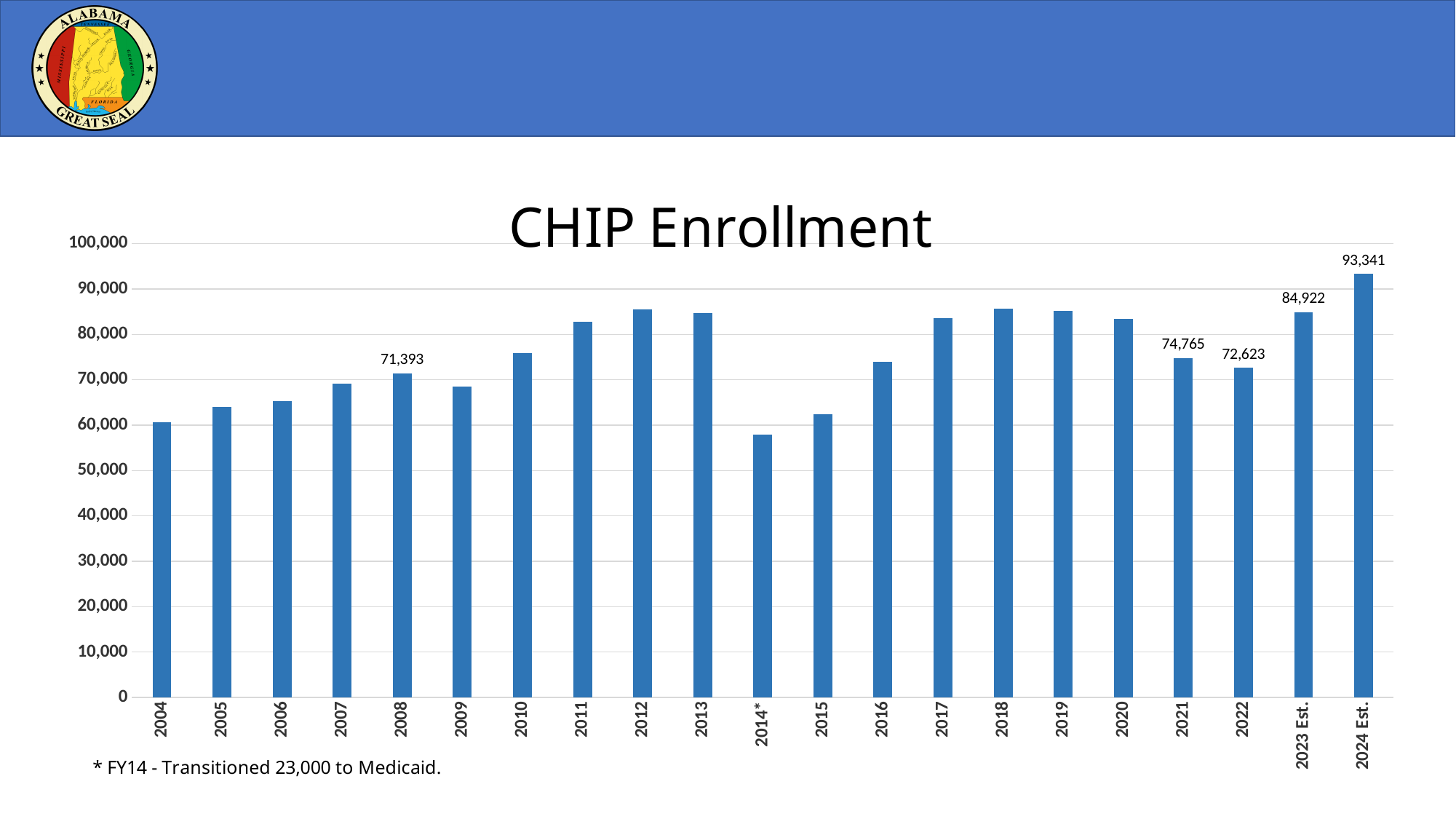
What is the CHIP enrollment value shown for 2024 Est.? 93,341 What is the difference between the 2021 and 2022 enrollment values? 2,142 Which year has the lowest CHIP enrollment? 2014* Is the enrollment value for 2014* greater or less than 60,000? less What kind of chart is shown on the slide? bar chart What is the title of the chart? CHIP Enrollment Which year has the highest CHIP enrollment? 2024 Est. What is the difference between the 2024 Est. and 2023 Est. enrollment values? 8,419 Which year has the larger enrollment, 2021 or 2022? 2021 What is the CHIP enrollment value shown for 2022? 72,623 What is the CHIP enrollment value shown for 2008? 71,393 How many years (bars) are shown on the chart? 21